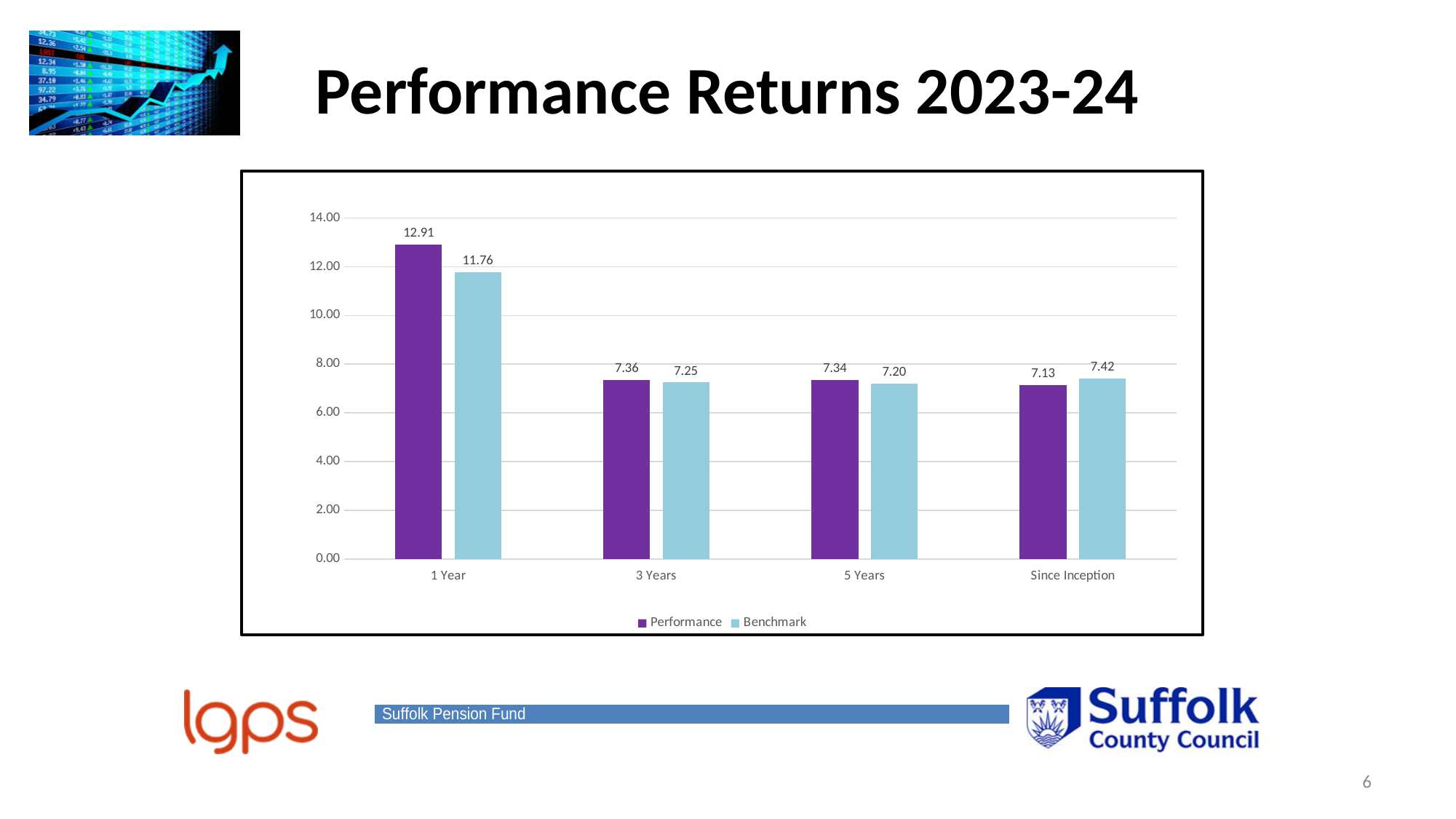
What is the Benchmark value for Since Inception? 7.42 How many periods are shown on the x axis? 4 Which period has the highest Performance value? 1 Year How many series does the legend list? 2 What is the Performance value for 1 Year? 12.91 What is the difference between the Performance and Benchmark values for 1 Year? 1.15 What kind of chart is shown on the slide? Bar chart For Since Inception, which is larger: Performance or Benchmark? Benchmark What is the Benchmark value for 5 Years? 7.20 Is the Benchmark value for 1 Year greater or less than 10.00? greater Which colour represents the Benchmark series? Light blue Which period has the lowest Performance value? Since Inception